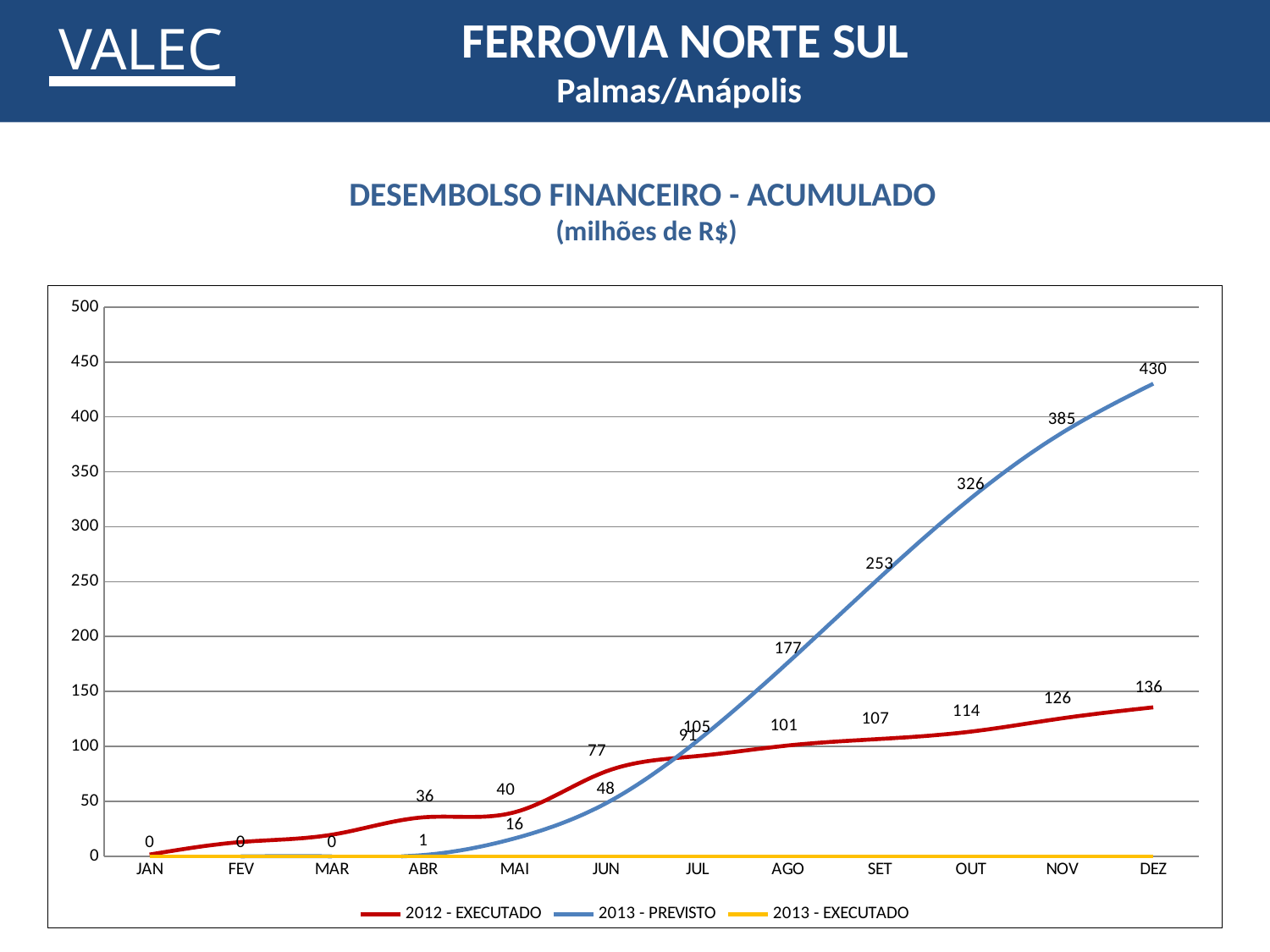
What is the value of 2013 - PREVISTO in DEZ? 430 What is the value of 2012 - EXECUTADO in DEZ? 136 What is the difference between 2013 - PREVISTO and 2012 - EXECUTADO in DEZ? 294 What is the value of 2013 - PREVISTO in AGO? 177 Is the value for 2013 - EXECUTADO in DEZ greater or less than 50? less In JUN, which is larger: 2012 - EXECUTADO or 2013 - PREVISTO? 2012 - EXECUTADO How many months are shown on the x axis? 12 Does the 2013 - PREVISTO series rise or fall from ABR to DEZ? rise What is the value of 2012 - EXECUTADO in JUN? 77 What kind of chart is shown on the slide? line chart How many series does the legend list? 3 In which month does 2013 - PREVISTO reach its highest value? DEZ